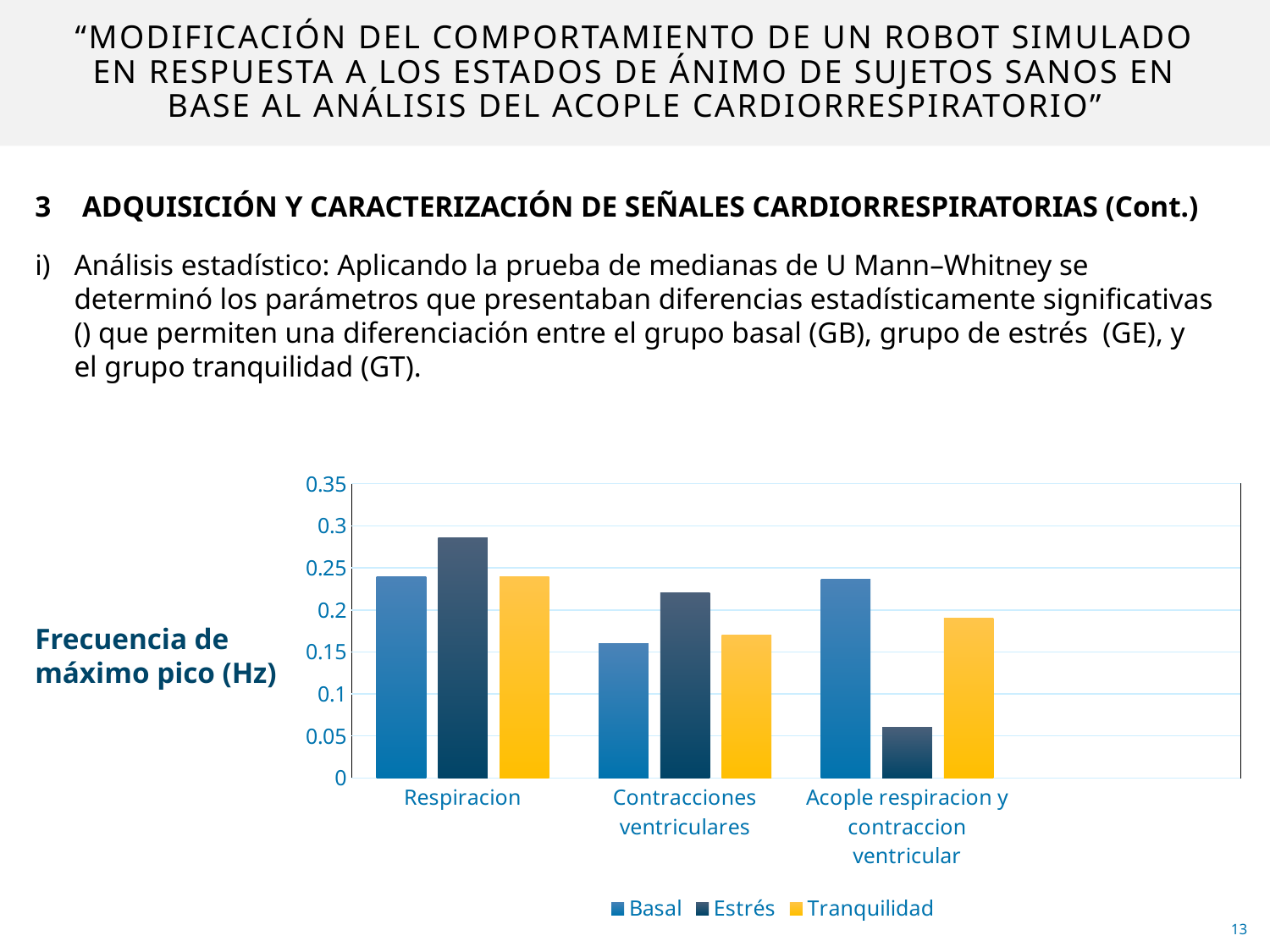
Is the Basal value for Contracciones ventriculares greater or less than 0.2? less Which is larger for Acople respiracion y contraccion ventricular: the Estrés value or the Tranquilidad value? Tranquilidad Is the Estrés value for Respiracion greater or less than 0.25? greater Is the Estrés value for Acople respiracion y contraccion ventricular greater or less than 0.1? less What kind of chart is shown on the slide? bar chart Which series has the highest value for Contracciones ventriculares? Estrés Which is larger: the Basal value for Respiracion or the Basal value for Contracciones ventriculares? Respiracion How many categories are shown on the x axis of the chart? 3 What is the label of the vertical axis of the chart? Frecuencia de máximo pico (Hz) Which series has the lowest value for Acople respiracion y contraccion ventricular? Estrés Which series has the highest value for Respiracion? Estrés How many series does the chart legend list? 3